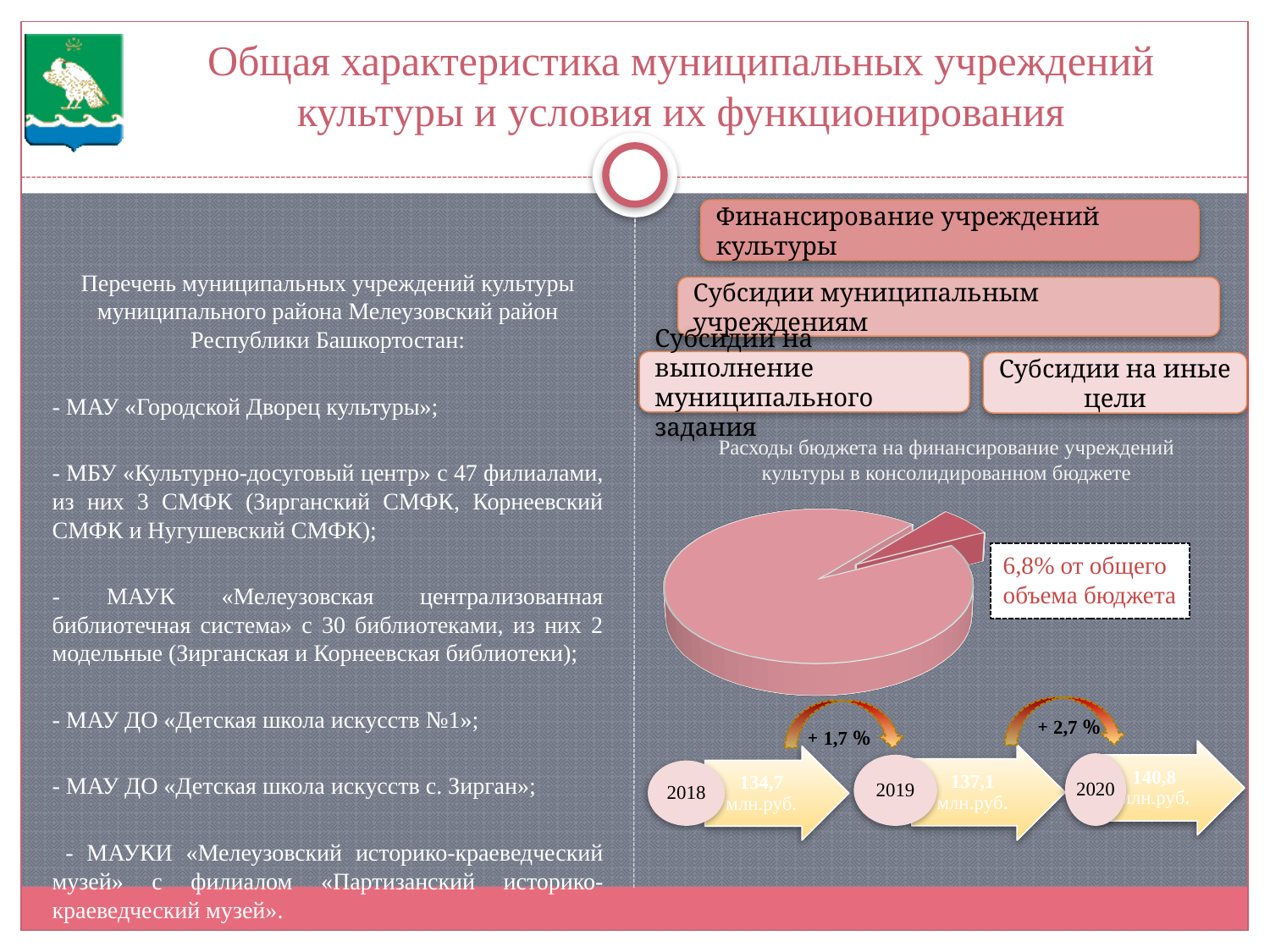
What kind of chart is shown under the heading "Расходы бюджета на финансирование учреждений культуры в консолидированном бюджете"? pie chart In the pie chart, is the exploded slice larger or smaller than the remaining slice? smaller How many slices does the pie chart have? 2 Is the share of the exploded slice in the pie chart greater or less than 10%? less What is the title of the pie chart? Расходы бюджета на финансирование учреждений культуры в консолидированном бюджете In the pie chart, what share of the total budget does the exploded (pulled-out) slice represent? 6,8%